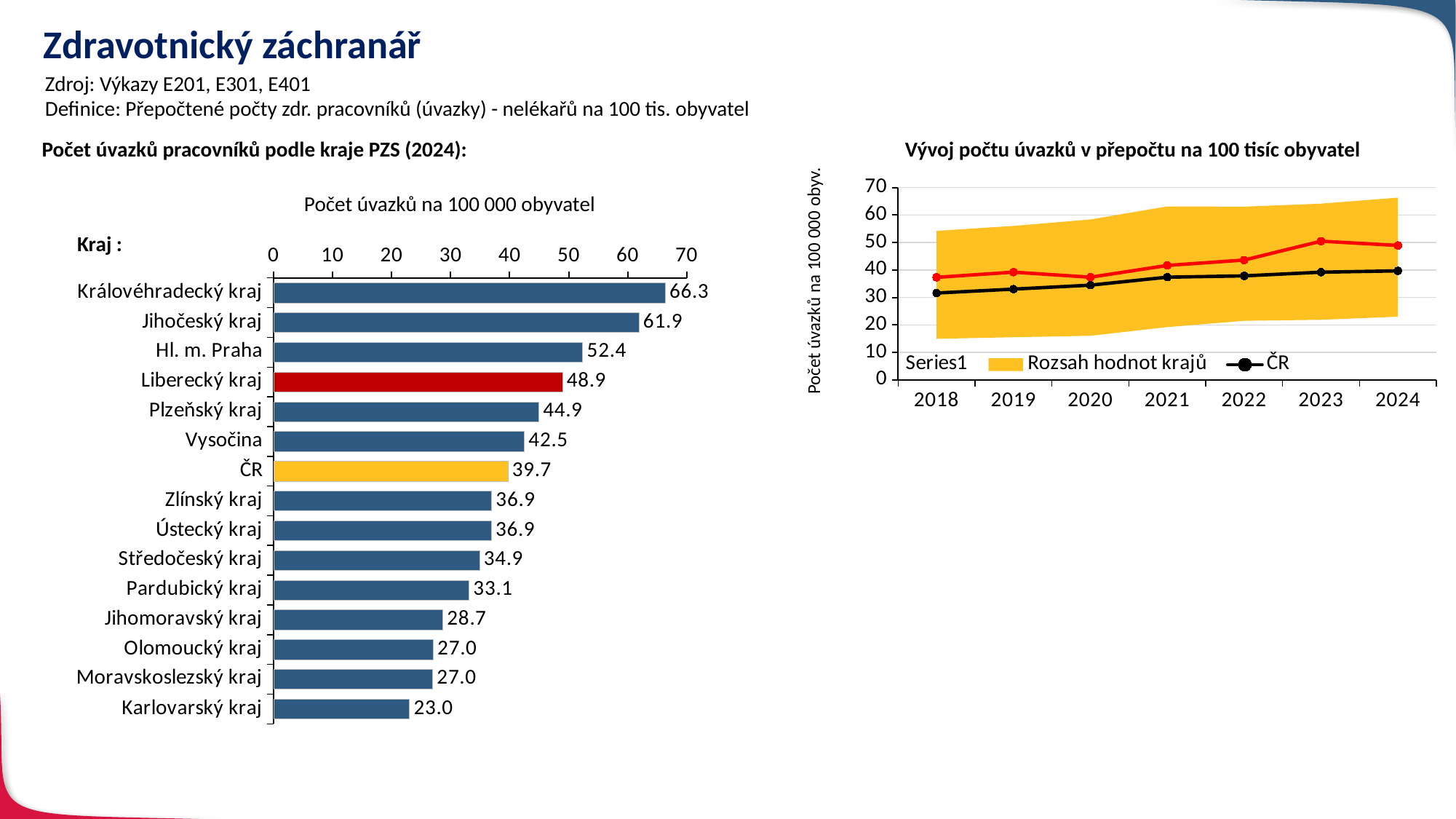
In the bar chart 'Počet úvazků pracovníků podle kraje PZS (2024)', what is the difference between Královéhradecký kraj and Karlovarský kraj? 43.3 In the chart 'Vývoj počtu úvazků v přepočtu na 100 tisíc obyvatel', does the ČR line rise or fall from 2018 to 2024? rise In the chart 'Vývoj počtu úvazků v přepočtu na 100 tisíc obyvatel', is the value of the ČR line in 2018 greater or less than 40? less In the bar chart 'Počet úvazků pracovníků podle kraje PZS (2024)', what is the value for ČR? 39.7 In the bar chart 'Počet úvazků pracovníků podle kraje PZS (2024)', which region has the lowest value? Karlovarský kraj In the bar chart 'Počet úvazků pracovníků podle kraje PZS (2024)', which region has the highest value? Královéhradecký kraj In the bar chart 'Počet úvazků pracovníků podle kraje PZS (2024)', how many bars are shown? 15 What type of chart is the left chart 'Počet úvazků pracovníků podle kraje PZS (2024)'? Bar chart In the bar chart 'Počet úvazků pracovníků podle kraje PZS (2024)', what is the value for Liberecký kraj? 48.9 In the bar chart 'Počet úvazků pracovníků podle kraje PZS (2024)', what is the difference between Liberecký kraj and ČR? 9.2 How many entries does the legend of the chart 'Vývoj počtu úvazků v přepočtu na 100 tisíc obyvatel' list? 3 In the bar chart 'Počet úvazků pracovníků podle kraje PZS (2024)', which is larger, Hl. m. Praha or Plzeňský kraj? Hl. m. Praha